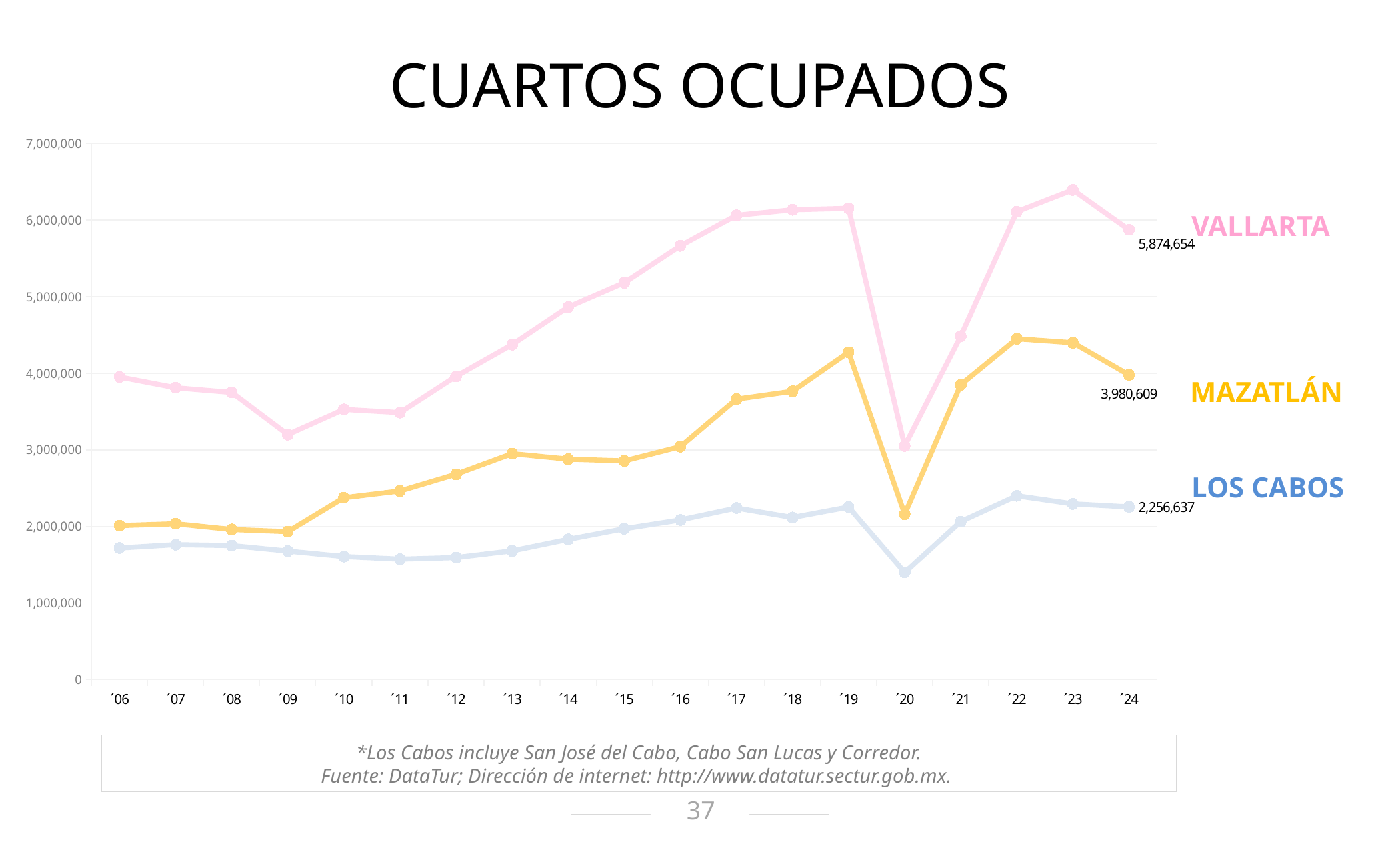
Is the value for VALLARTA in ´23 greater or less than 6,000,000? greater What is the value for VALLARTA in ´24? 5,874,654 Which is larger for MAZATLÁN: the value in ´19 or the value in ´20? ´19 In ´24, how much higher is VALLARTA than MAZATLÁN? 1,894,045 What kind of chart is shown on the slide? line chart How many series are plotted on the chart? 3 How many years are shown on the x axis? 19 Which series has the highest value in ´24? VALLARTA In which year does LOS CABOS reach its lowest value? ´20 In ´24, what is the difference between MAZATLÁN and LOS CABOS? 1,723,972 What is the value for LOS CABOS in ´24? 2,256,637 What is the value for MAZATLÁN in ´24? 3,980,609